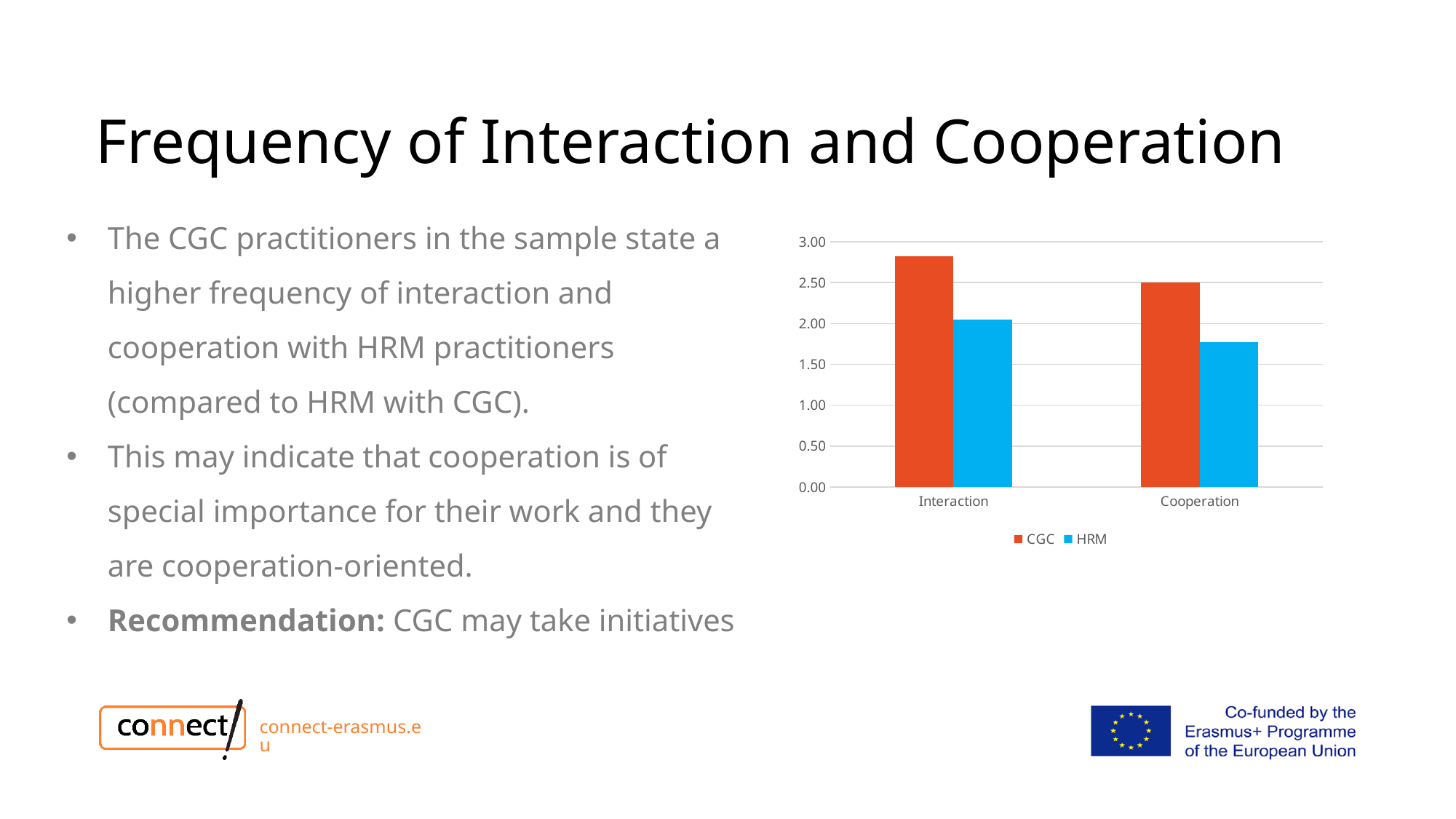
How many categories are shown on the x axis of the chart? 2 Is the CGC value for Interaction greater or less than 2.50? greater Which bar in the chart is the shortest? HRM for Cooperation Is the HRM value for Cooperation greater or less than 2.00? less How many series does the chart legend list? 2 Does the CGC value rise or fall from Interaction to Cooperation? fall Which colour represents the HRM series in the chart? blue What kind of chart is shown on the slide? bar chart Which series has the higher value for Interaction, CGC or HRM? CGC Which series has the higher value for Cooperation, CGC or HRM? CGC Is the HRM value for Interaction greater or less than 2.50? less Which bar in the chart is the tallest? CGC for Interaction